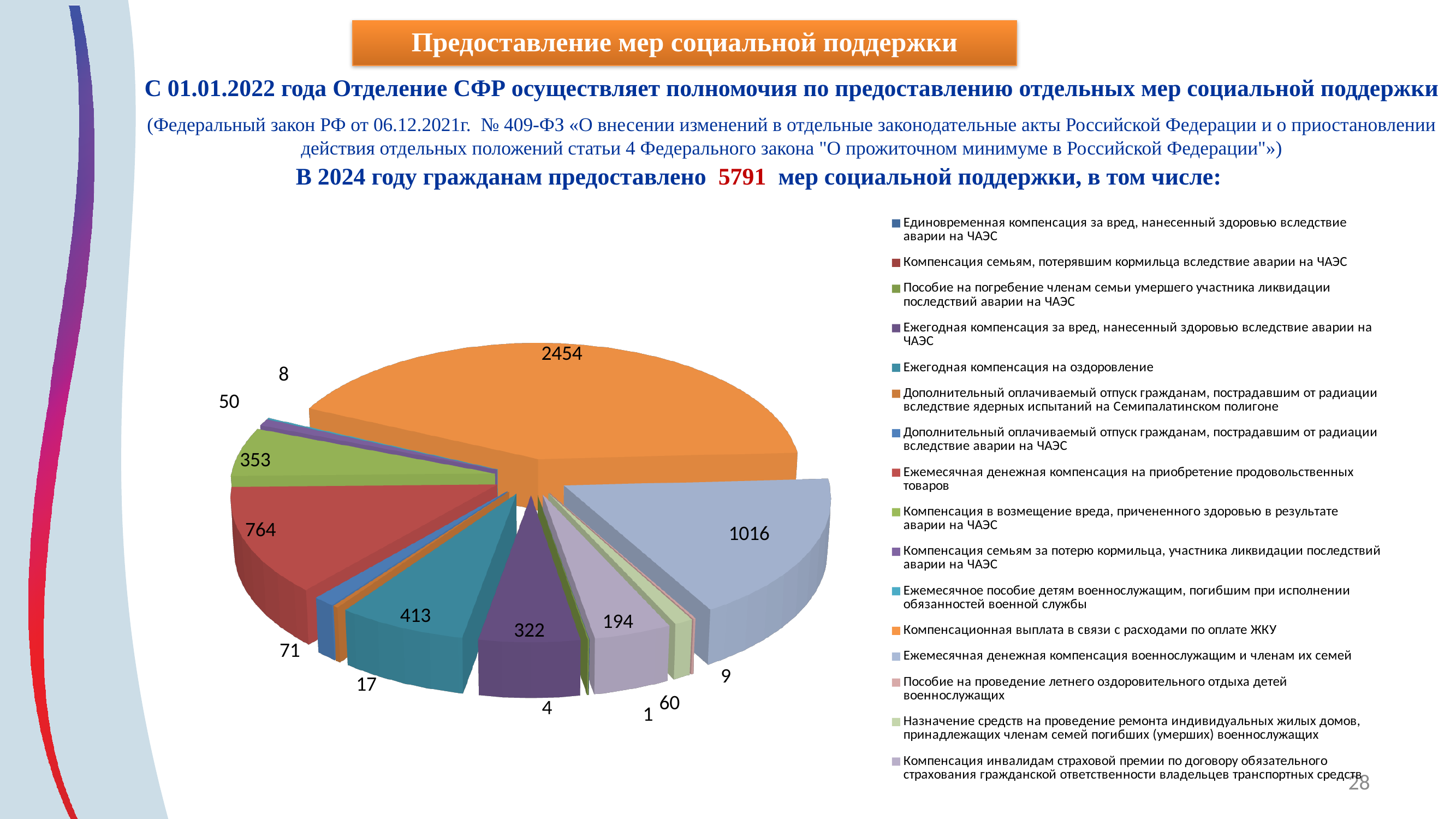
According to the slide text, how many measures of social support were provided in 2024 in total? 5791 What is the largest value labelled on the pie chart? 2454 What kind of chart is shown on the slide? pie chart What is the smallest value labelled on the pie chart? 1 What is the difference between the two largest slices, labelled 2454 and 1016? 1438 Which is larger: the slice labelled 353 or the slice labelled 322? 353 What is the difference between the slices labelled 413 and 322? 91 What value is shown for 'Компенсационная выплата в связи с расходами по оплате ЖКУ' (the large orange slice)? 2454 How many entries does the legend of the pie chart list? 16 Which is larger: the slice labelled 764 or the slice labelled 413? 764 What value is shown for 'Ежемесячная денежная компенсация военнослужащим и членам их семей' (the light blue slice)? 1016 What is the difference between the slices labelled 764 and 353? 411